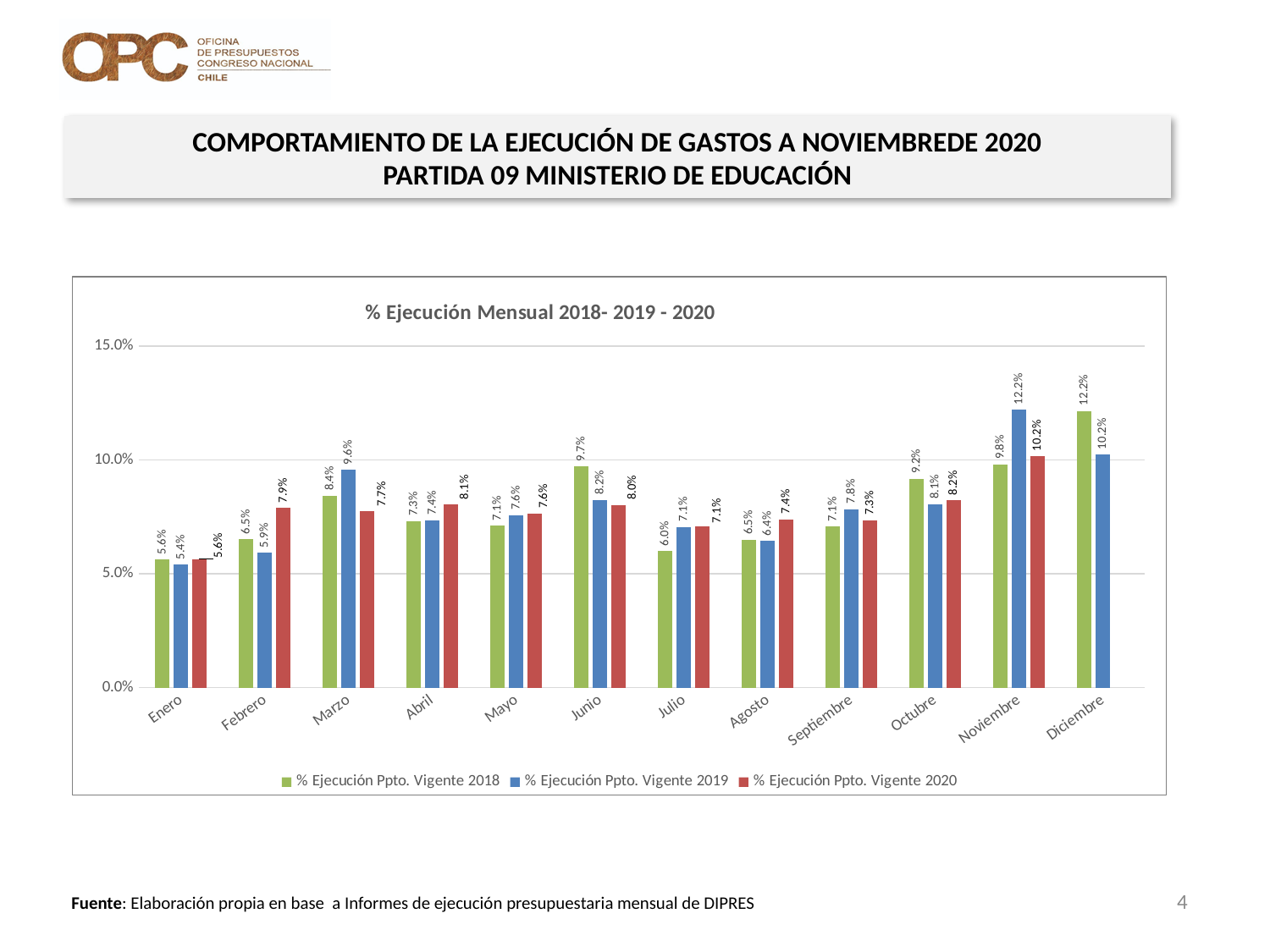
What is the value for % Ejecución Ppto. Vigente 2020 in Noviembre? 10.2% How many months are shown on the x axis? 12 What is the value for % Ejecución Ppto. Vigente 2018 in Junio? 9.7% What kind of chart is shown on the slide? Bar chart How many series does the legend list? 3 Is the value for % Ejecución Ppto. Vigente 2018 in Diciembre greater or less than 10.0%? greater In which month is the % Ejecución Ppto. Vigente 2019 series highest? Noviembre In which month is the % Ejecución Ppto. Vigente 2018 series lowest? Enero What is the title of the chart? % Ejecución Mensual 2018- 2019 - 2020 What is the difference between the 2019 and 2018 values in Noviembre? 2.4% Which is larger in Febrero: the 2020 value or the 2018 value? 2020 value (7.9%) What is the value for % Ejecución Ppto. Vigente 2019 in Marzo? 9.6%